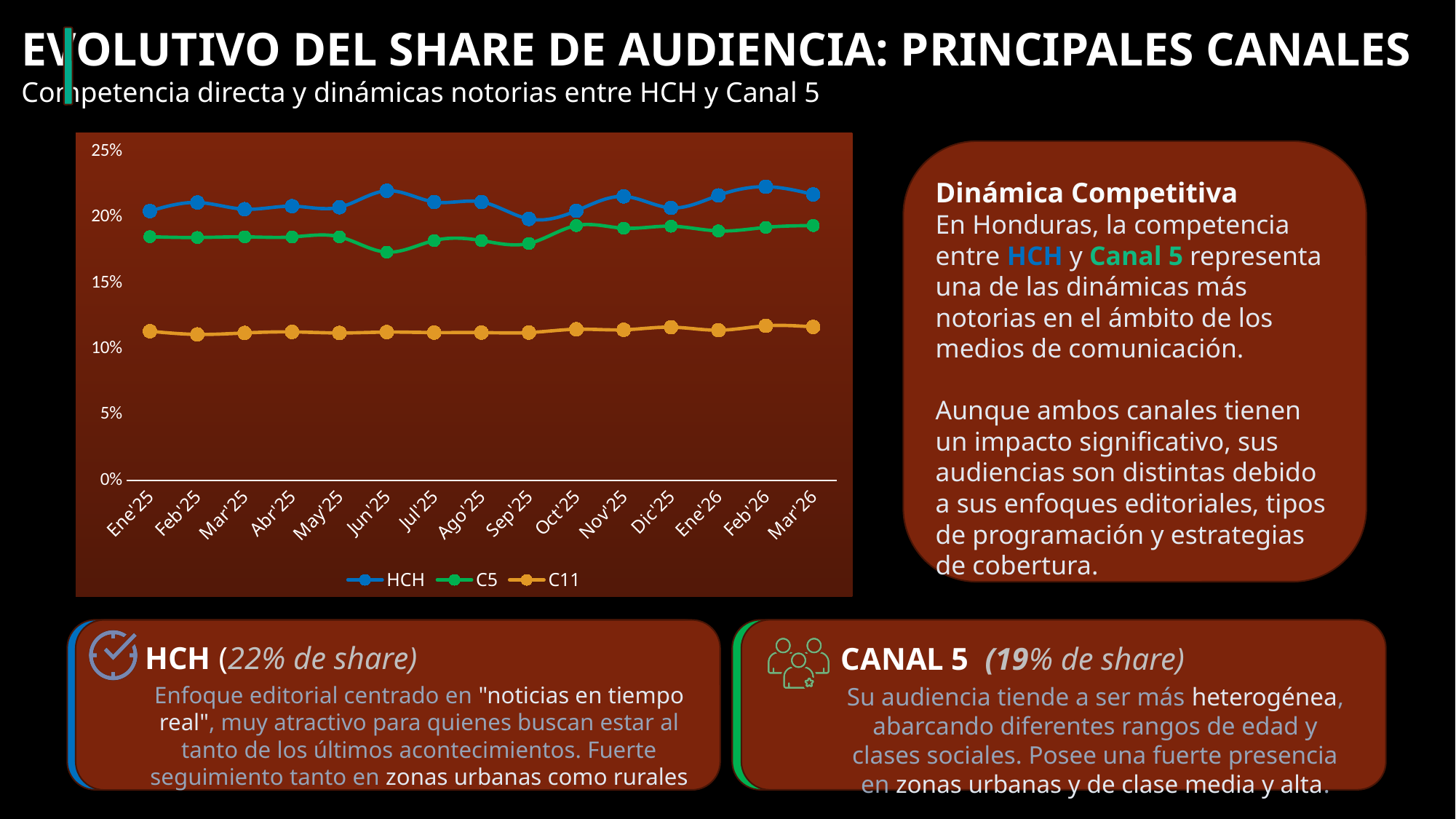
Is the value for HCH in Jun'25 greater or less than 20%? greater What kind of chart is shown on the slide? line chart How many months are plotted along the x axis of the chart? 15 In which month does the C5 series reach its lowest point? Jun'25 Which series has the lowest share across the whole period? C11 What colour is the HCH line in the chart? blue Which is larger in Ene'25, the value for HCH or the value for C5? HCH Is the value for C11 in Ene'25 greater or less than 15%? less How many series does the chart legend list? 3 Which is larger in Mar'26, the value for C5 or the value for C11? C5 Which series has the highest share across the whole period? HCH Is the value for C5 in Jun'25 greater or less than 20%? less